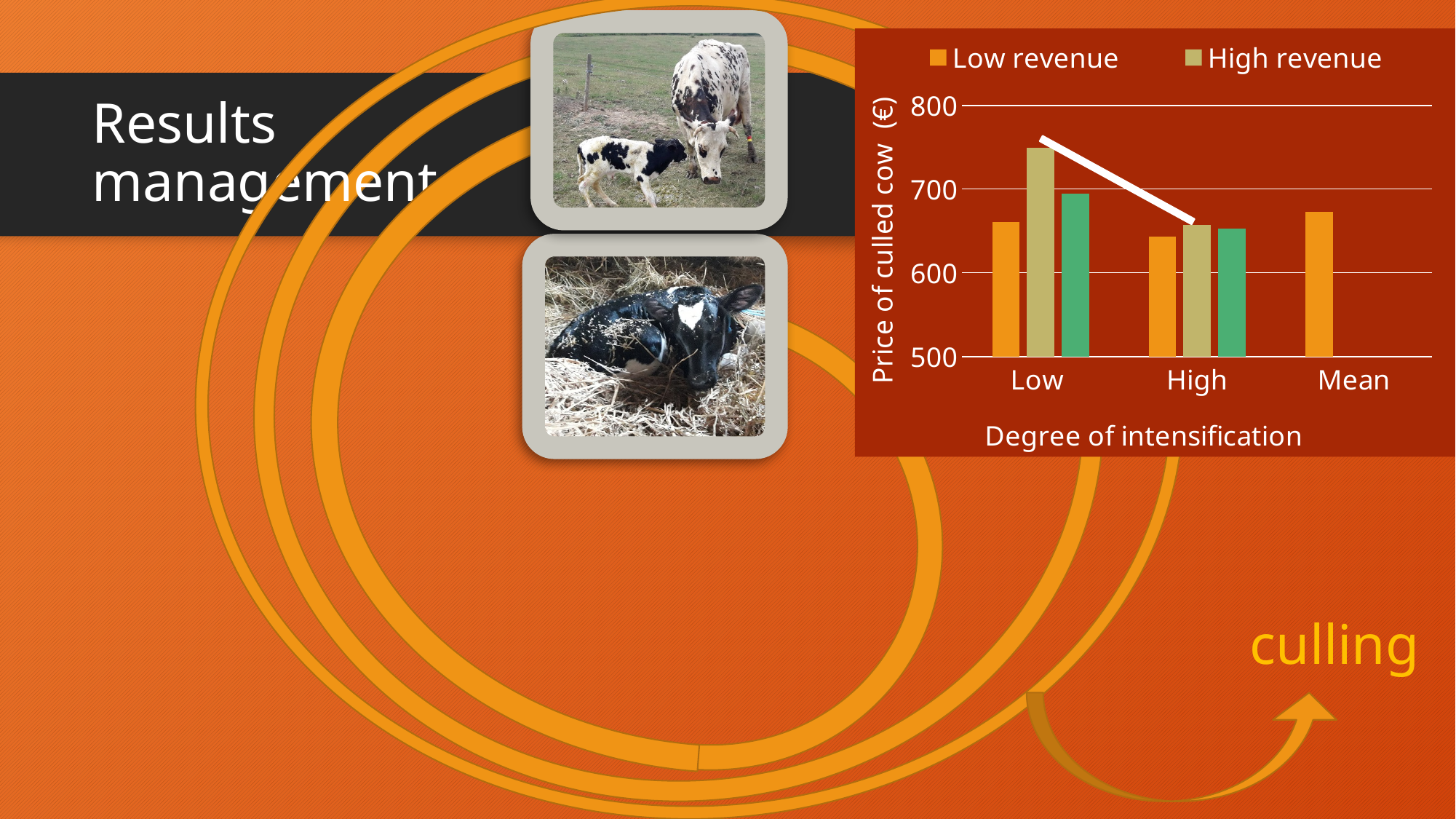
Which category has the tallest High revenue bar? Low Is the High revenue value for the High category greater or less than 700? less How many categories are shown on the x axis of the chart? 3 Is the Low revenue value for the Mean category greater or less than 600? greater What is the x-axis label of the chart? Degree of intensification Does the High revenue series rise or fall from the Low category to the High category? fall Is the Low revenue value for the Low category greater or less than 700? less In the Low category, which is larger: the Low revenue bar or the High revenue bar? High revenue What is the y-axis label of the chart? Price of culled cow (€) What kind of chart is shown on the slide? bar chart How many series does the chart legend list? 2